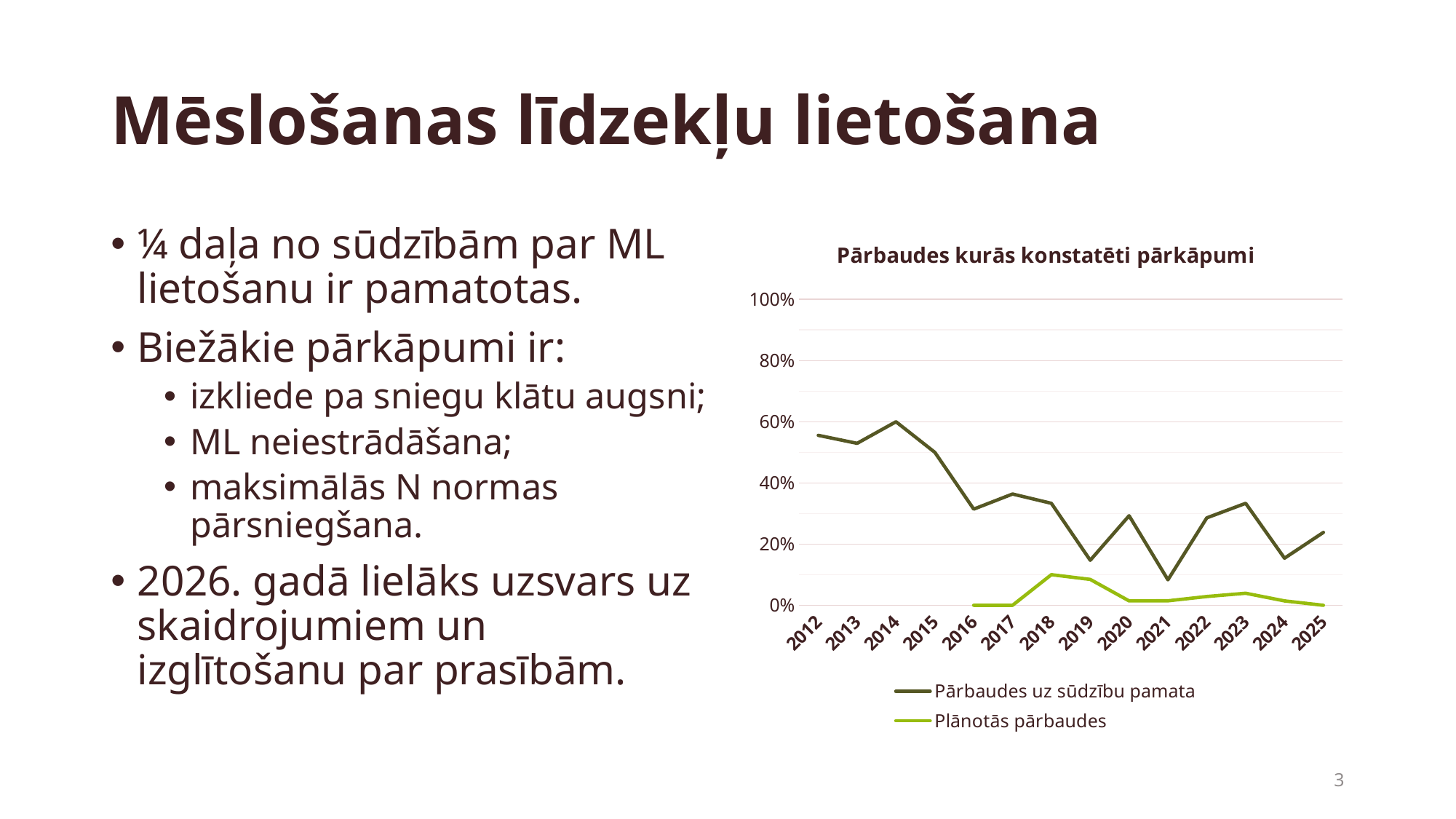
In which year does the 'Pārbaudes uz sūdzību pamata' series reach its lowest value? 2021 How many years are shown on the x axis of the chart? 14 For 'Pārbaudes uz sūdzību pamata', which year has the larger value, 2023 or 2024? 2023 Is the value for 'Pārbaudes uz sūdzību pamata' in 2014 greater or less than 40%? greater How many series does the legend of the chart list? 2 What kind of chart is shown on the slide? line chart In which year does the 'Pārbaudes uz sūdzību pamata' series reach its highest value? 2014 What is the title of the chart? Pārbaudes kurās konstatēti pārkāpumi Does the 'Pārbaudes uz sūdzību pamata' series overall rise or fall from 2012 to 2025? fall Which series is drawn with the light green line? Plānotās pārbaudes Is the value for 'Pārbaudes uz sūdzību pamata' in 2021 greater or less than 20%? less Is the value for 'Plānotās pārbaudes' in 2018 greater or less than 20%? less